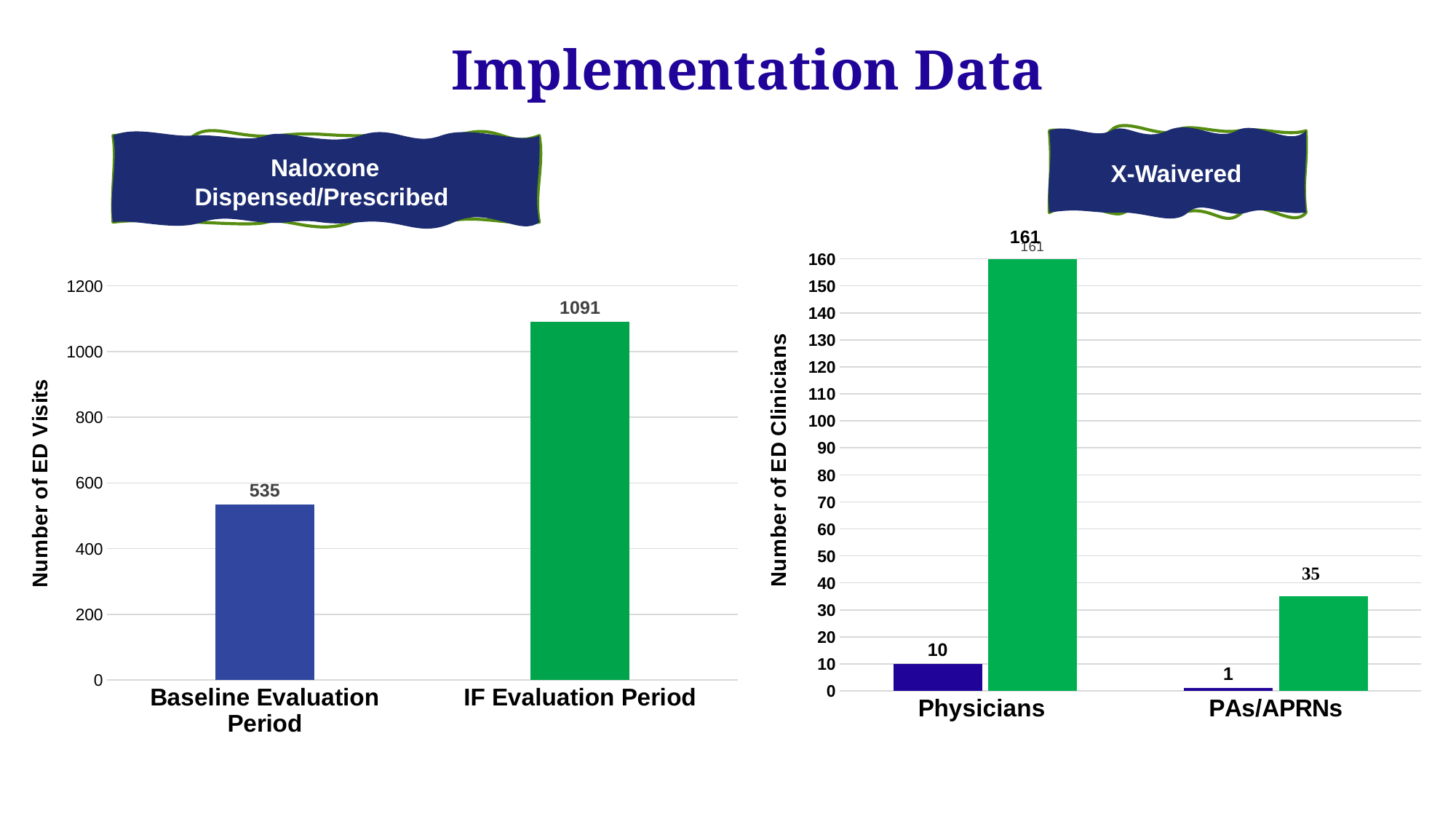
In the X-Waivered chart, what is the value of the green bar for Physicians? 161 In the Naloxone Dispensed/Prescribed chart, which period has the higher number of ED visits? IF Evaluation Period In the Naloxone Dispensed/Prescribed chart, what is the number of ED visits for the IF Evaluation Period? 1091 In the X-Waivered chart, what is the value of the dark blue bar for PAs/APRNs? 1 What kind of chart is the Naloxone Dispensed/Prescribed chart? Bar chart In the X-Waivered chart, which category has the lowest value overall? PAs/APRNs In the Naloxone Dispensed/Prescribed chart, how many categories are shown on the x axis? 2 In the X-Waivered chart, what is the value of the green bar for PAs/APRNs? 35 In the X-Waivered chart, what is the difference between the green bar and the dark blue bar for Physicians? 151 In the Naloxone Dispensed/Prescribed chart, what is the number of ED visits for the Baseline Evaluation Period? 535 What is the y-axis label of the X-Waivered chart? Number of ED Clinicians In the Naloxone Dispensed/Prescribed chart, what is the difference in ED visits between the IF Evaluation Period and the Baseline Evaluation Period? 556